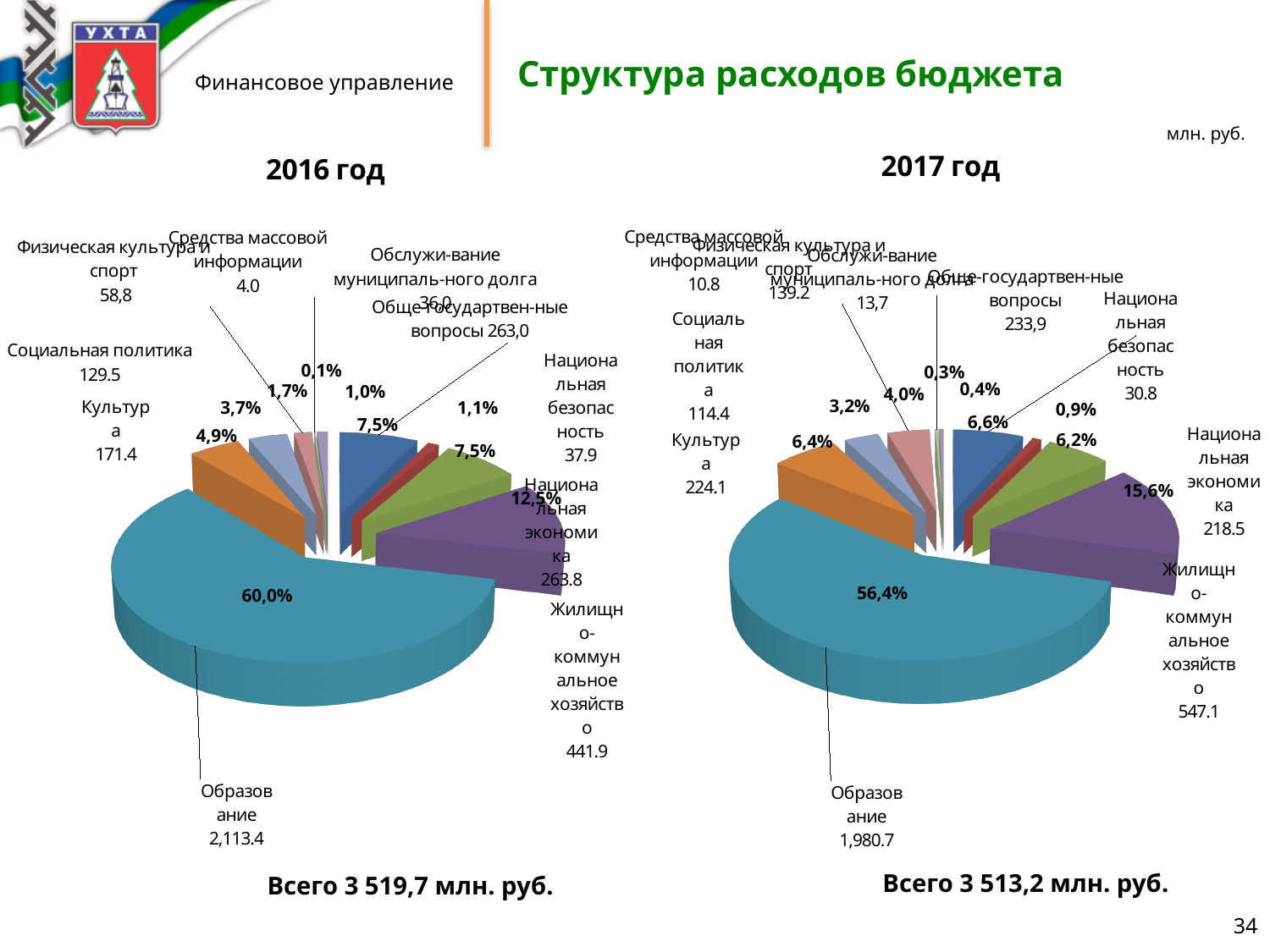
In the 2016 год chart, which category has the largest value? Образование What is the total shown below the 2016 год chart? 3 519,7 млн. руб. In the 2016 год chart, what is the value for Образование? 2,113.4 How many categories are shown in the 2017 год chart? 10 In the 2017 год chart, which category has the smallest value? Средства массовой информации In the 2016 год chart, what is the difference between Культура (171.4) and Социальная политика (129.5)? 41.9 In the 2017 год chart, what share of the pie does Образование take? 56,4% In the 2017 год chart, which is larger: Культура or Социальная политика? Культура In the 2017 год chart, what is the value for Национальная безопасность? 30.8 In the 2017 год chart, what is the value for Жилищно-коммунальное хозяйство? 547.1 What type of chart is used for the 2016 год chart? pie chart In the 2016 год chart, what share of the pie does Жилищно-коммунальное хозяйство take? 12,5%